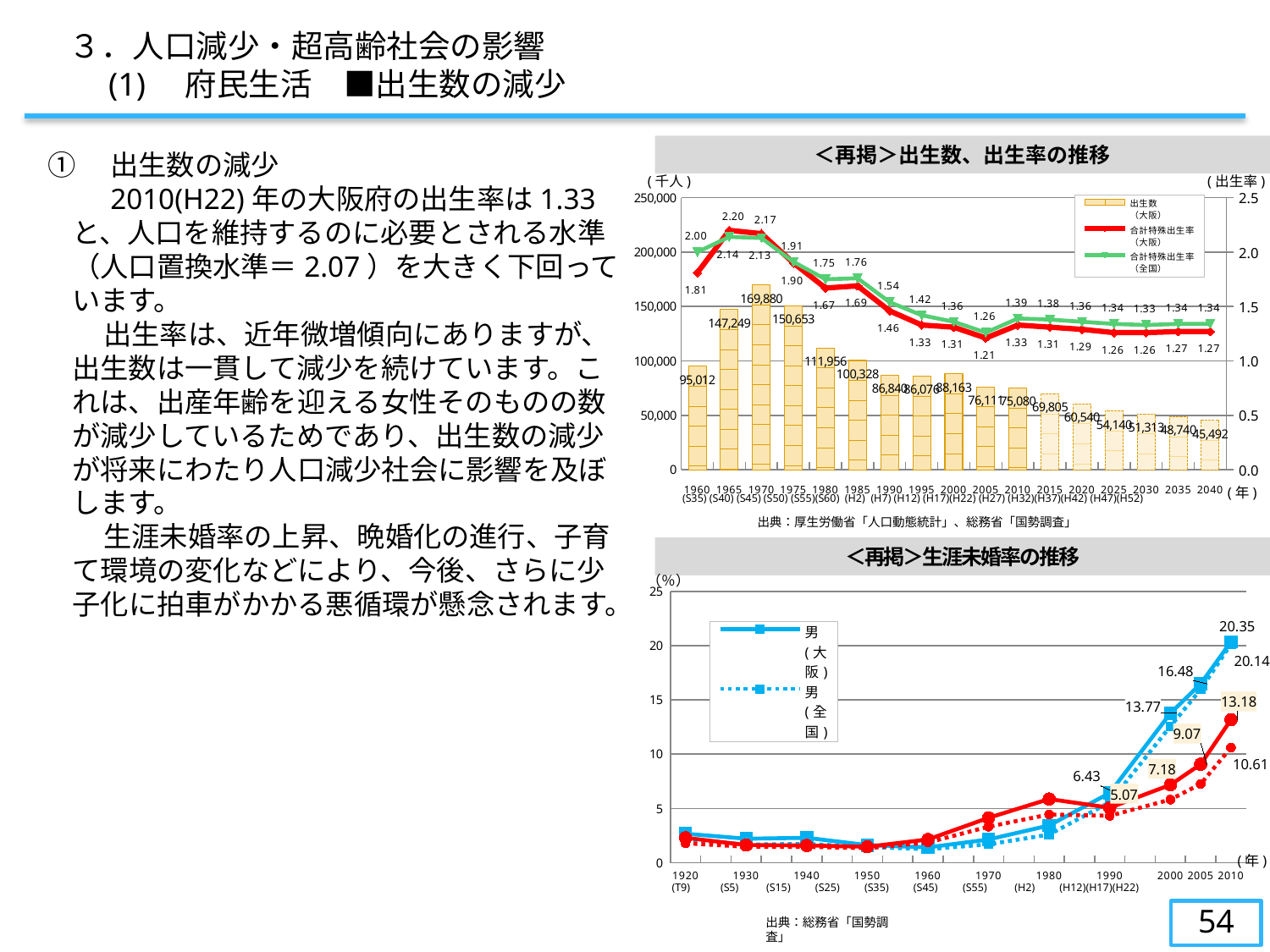
In the top chart (出生数、出生率の推移), what is the Osaka total fertility rate (合計特殊出生率（大阪）) in 2010? 1.33 In the top chart (出生数、出生率の推移), how many years are shown on the x axis? 17 What kind of chart is the top chart (出生数、出生率の推移)? A bar chart combined with line charts In the bottom chart (生涯未婚率の推移), is the value for 男（大阪） in 1980 greater or less than 5? less In the top chart (出生数、出生率の推移), what is the number of births (出生数) in 1970? 169,880 In the top chart (出生数、出生率の推移), which year has the highest number of births? 1970 In the bottom chart (生涯未婚率の推移), what is the value for 男（大阪） in 2010? 20.35 In the top chart (出生数、出生率の推移), what is the national total fertility rate (合計特殊出生率（全国）) in 2005? 1.26 In the top chart (出生数、出生率の推移), what is the difference between the number of births in 1965 and in 1960? 52,237 In the bottom chart (生涯未婚率の推移), what is the difference between the 男（大阪） values in 2010 and 2005? 3.87 In the top chart (出生数、出生率の推移), which year has the lowest number of births? 2040 In the top chart (出生数、出生率の推移), in 2010, which is higher: the Osaka fertility rate or the national fertility rate? National (全国), 1.39